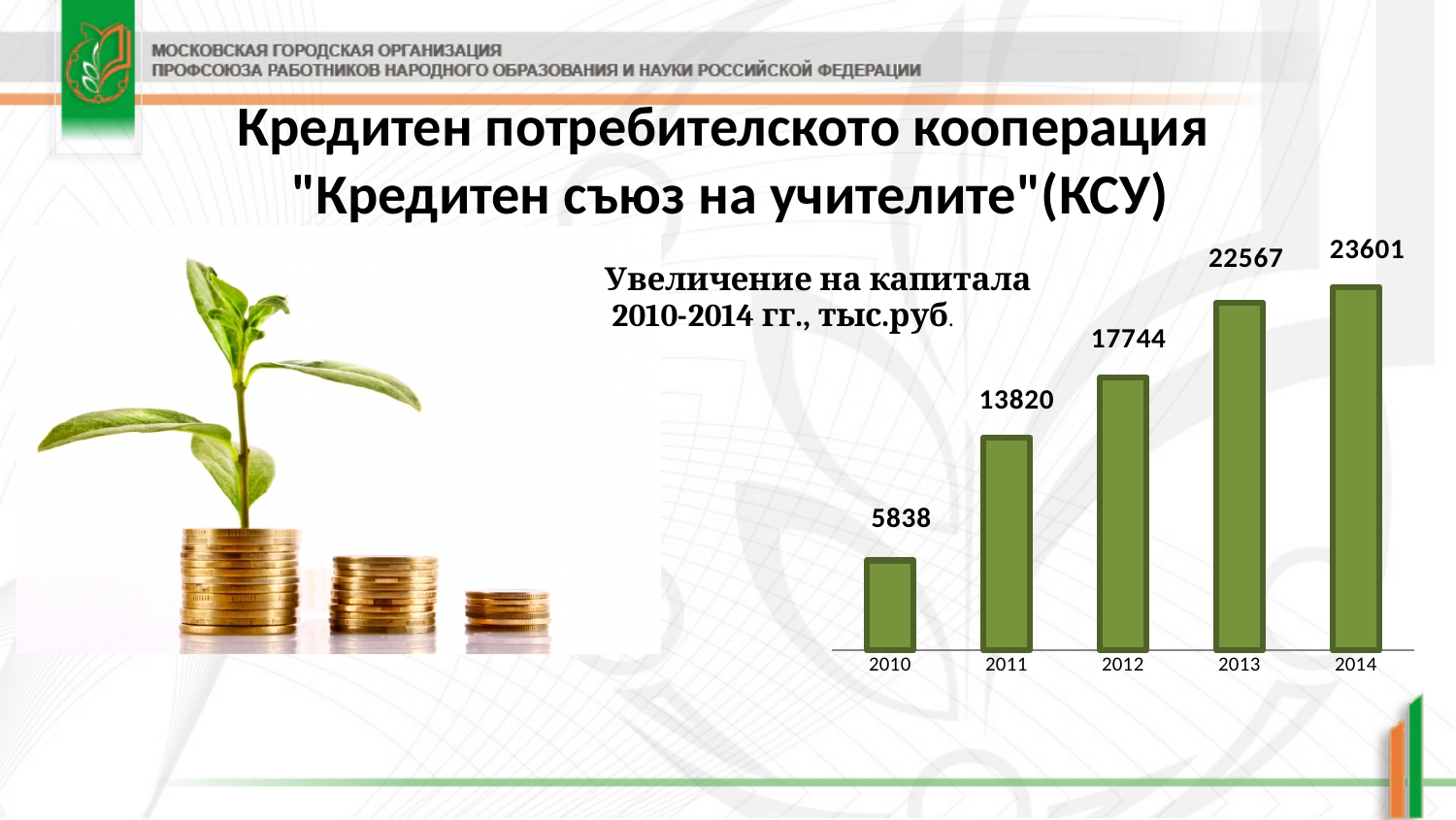
Which year has the lowest value? 2010 What is the value for 2014? 23601 Do the values rise or fall from 2010 to 2014? rise Which year has the highest value? 2014 What is the title of the chart? Увеличение на капитала 2010-2014 гг., тыс.руб. How many years are shown on the chart? 5 What is the value for 2012? 17744 What is the value for 2010? 5838 What kind of chart is shown? bar chart What is the difference between the values for 2011 and 2010? 7982 What is the difference between the values for 2014 and 2013? 1034 Which is larger, the value for 2012 or the value for 2013? 2013